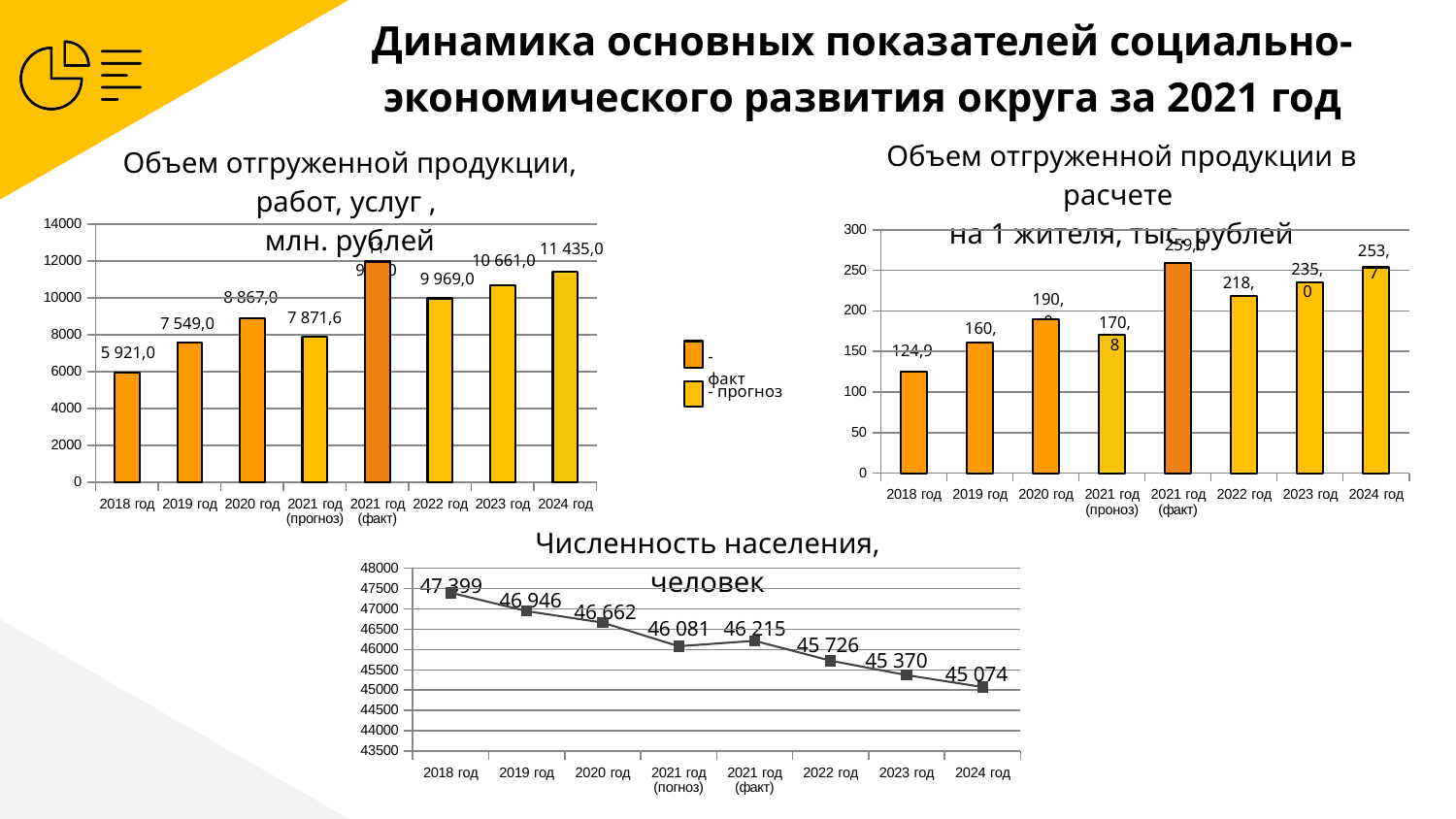
On the chart 'Объем отгруженной продукции в расчете на 1 жителя, тыс. рублей', what is the value for 2021 год (прогноз)? 170,8 On the chart 'Объем отгруженной продукции в расчете на 1 жителя, тыс. рублей', what is the value for 2018 год? 124,9 On the chart 'Численность населения, человек', what is the value for 2018 год? 47 399 On the chart 'Численность населения, человек', which year has the lowest value? 2024 год What kind of chart is 'Численность населения, человек'? line chart On the chart 'Объем отгруженной продукции, работ, услуг, млн. рублей', how many bars are plotted? 8 On the chart 'Объем отгруженной продукции, работ, услуг, млн. рублей', what is the value for 2021 год (прогноз)? 7 871,6 On the chart 'Объем отгруженной продукции, работ, услуг, млн. рублей', what is the value for 2018 год? 5 921,0 On the chart 'Объем отгруженной продукции в расчете на 1 жителя, тыс. рублей', is the value for 2022 год greater or less than 200? greater On the chart 'Объем отгруженной продукции, работ, услуг, млн. рублей', what is the difference between the values for 2023 год and 2022 год? 692,0 On the chart 'Объем отгруженной продукции, работ, услуг, млн. рублей', what is the value for 2024 год? 11 435,0 On the chart 'Объем отгруженной продукции, работ, услуг, млн. рублей', which is larger: the value for 2019 год or the value for 2020 год? 2020 год